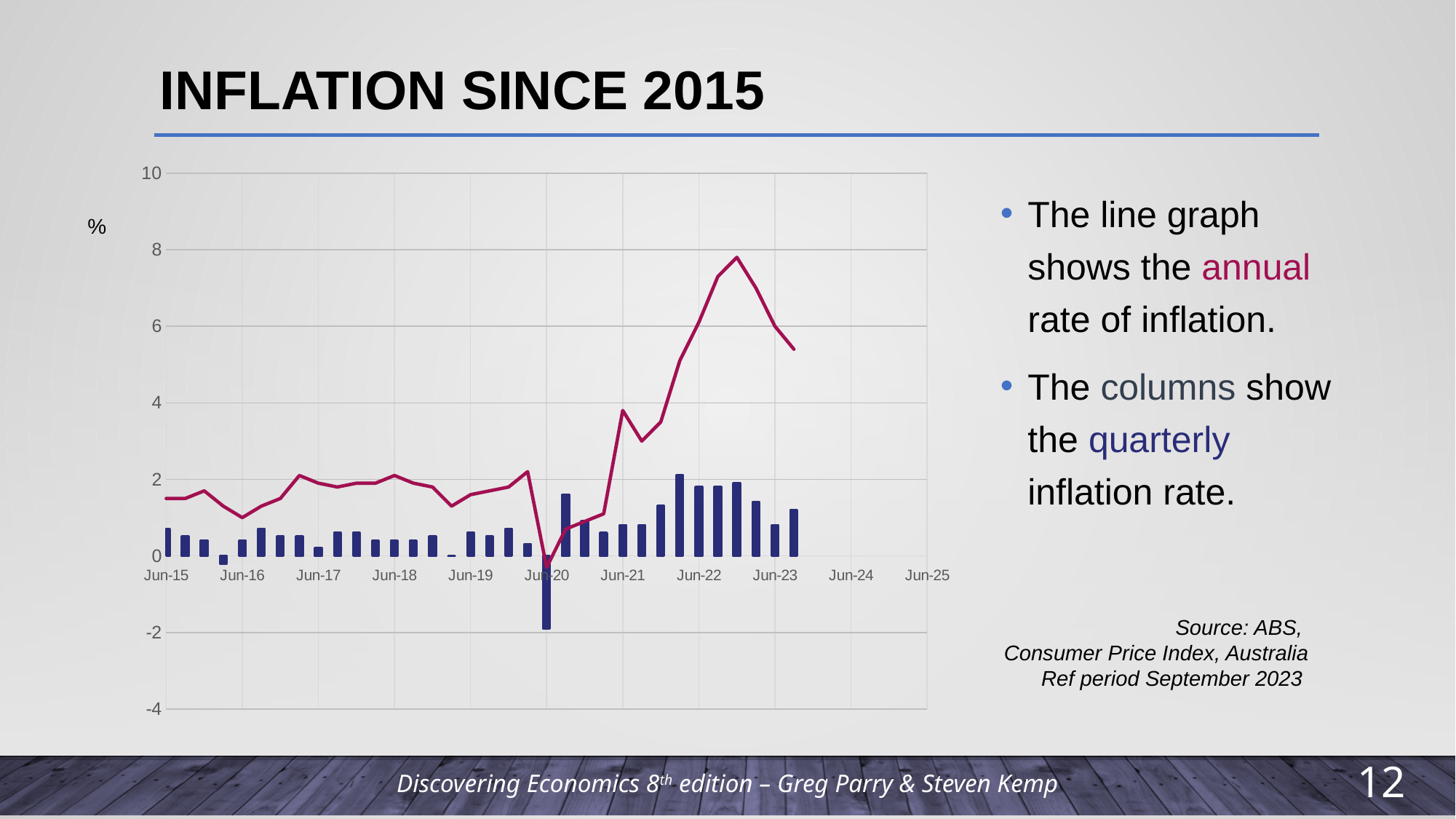
Is the peak value of the annual inflation line greater or less than 6? greater Is the quarterly inflation column at Jun-20 greater or less than 0? less What is the title of the chart? INFLATION SINCE 2015 What kind of chart is shown on the slide? A combined line and bar chart Which x-axis label is closest to the lowest quarterly inflation column? Jun-20 What unit is shown on the vertical axis of the chart? % Does the annual inflation line rise or fall from its peak to the last plotted point? fall How many date labels are shown along the x axis of the chart? 11 Does the annual inflation line rise or fall between Jun-20 and Jun-21? rise Is the quarterly inflation column at Jun-22 greater or less than 1? greater